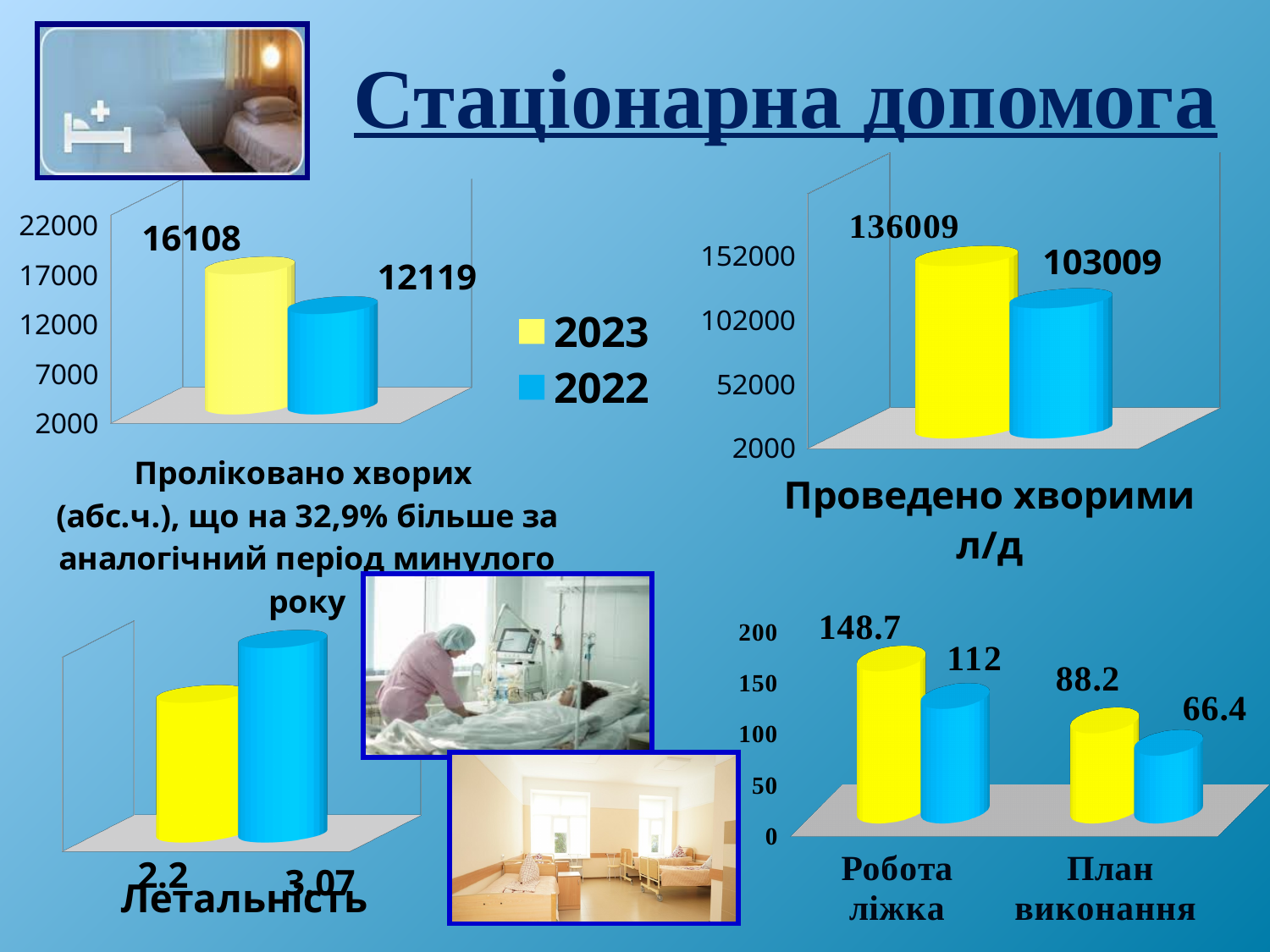
In the bottom-right chart, what is the 2022 value for 'План виконання'? 66.4 In the chart titled 'Проведено хворими л/д', which year has the higher value, 2023 or 2022? 2023 How many series does the legend on the slide list? 2 In the chart titled 'Проведено хворими л/д', what is the value for 2023? 136009 In the chart titled 'Летальність', what is the value of the blue (2022) bar? 3.07 In the chart titled 'Проліковано хворих', what is the difference between the 2023 and 2022 values? 3989 In the bottom-right chart, how many categories are shown on the x axis? 2 In the bottom-right chart, what is the 2023 value for 'Робота ліжка'? 148.7 In the chart titled 'Проліковано хворих', what is the value for 2022? 12119 In the chart titled 'Летальність', which bar is lower, the yellow (2023) or the blue (2022)? yellow (2023) In the chart titled 'Проліковано хворих', what is the value for 2023? 16108 In the chart titled 'Проведено хворими л/д', what is the difference between the 2023 and 2022 values? 33000